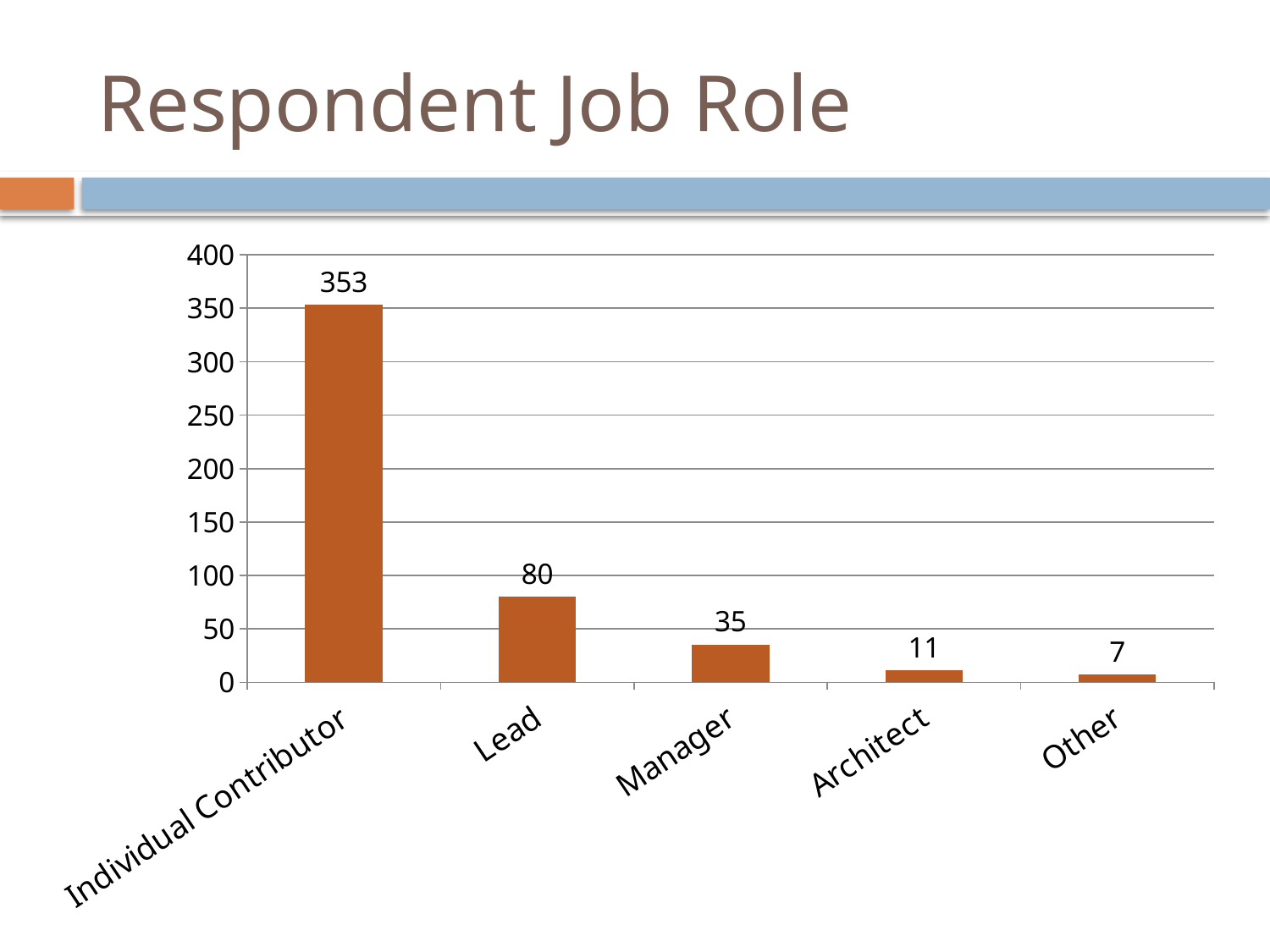
What is the value for Other? 7 What is the value for Manager? 35 How many job role categories are shown on the chart? 5 Which is larger, the value for Lead or the value for Manager? Lead What is the difference between the values for Individual Contributor and Lead? 273 What is the difference between the values for Manager and Architect? 24 What is the value for Individual Contributor? 353 What kind of chart is shown on the slide? Bar chart What is the value for Lead? 80 What is the value for Architect? 11 Which job role has the highest number of respondents? Individual Contributor Which job role has the lowest number of respondents? Other